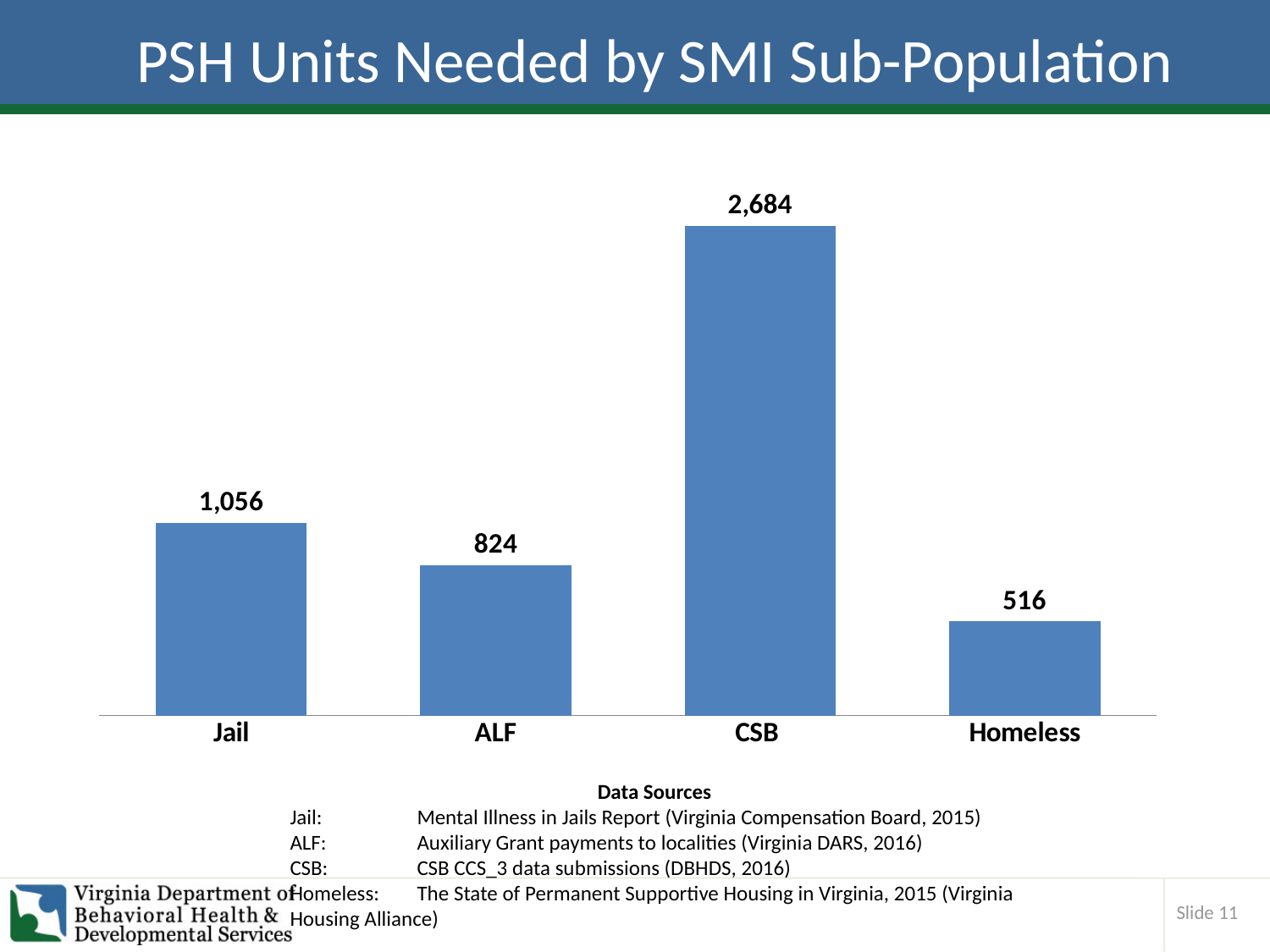
What kind of chart is shown on the slide? Bar chart What is the value for Jail? 1,056 What is the value for Homeless? 516 What is the title of the slide? PSH Units Needed by SMI Sub-Population What is the value for ALF? 824 What is the difference between the values for ALF and Homeless? 308 How many sub-population categories are shown in the chart? 4 What is the difference between the values for CSB and Jail? 1,628 Which sub-population has the lowest number of PSH units needed? Homeless What is the value for CSB? 2,684 Which sub-population has the highest number of PSH units needed? CSB Which is larger, the value for Jail or the value for ALF? Jail